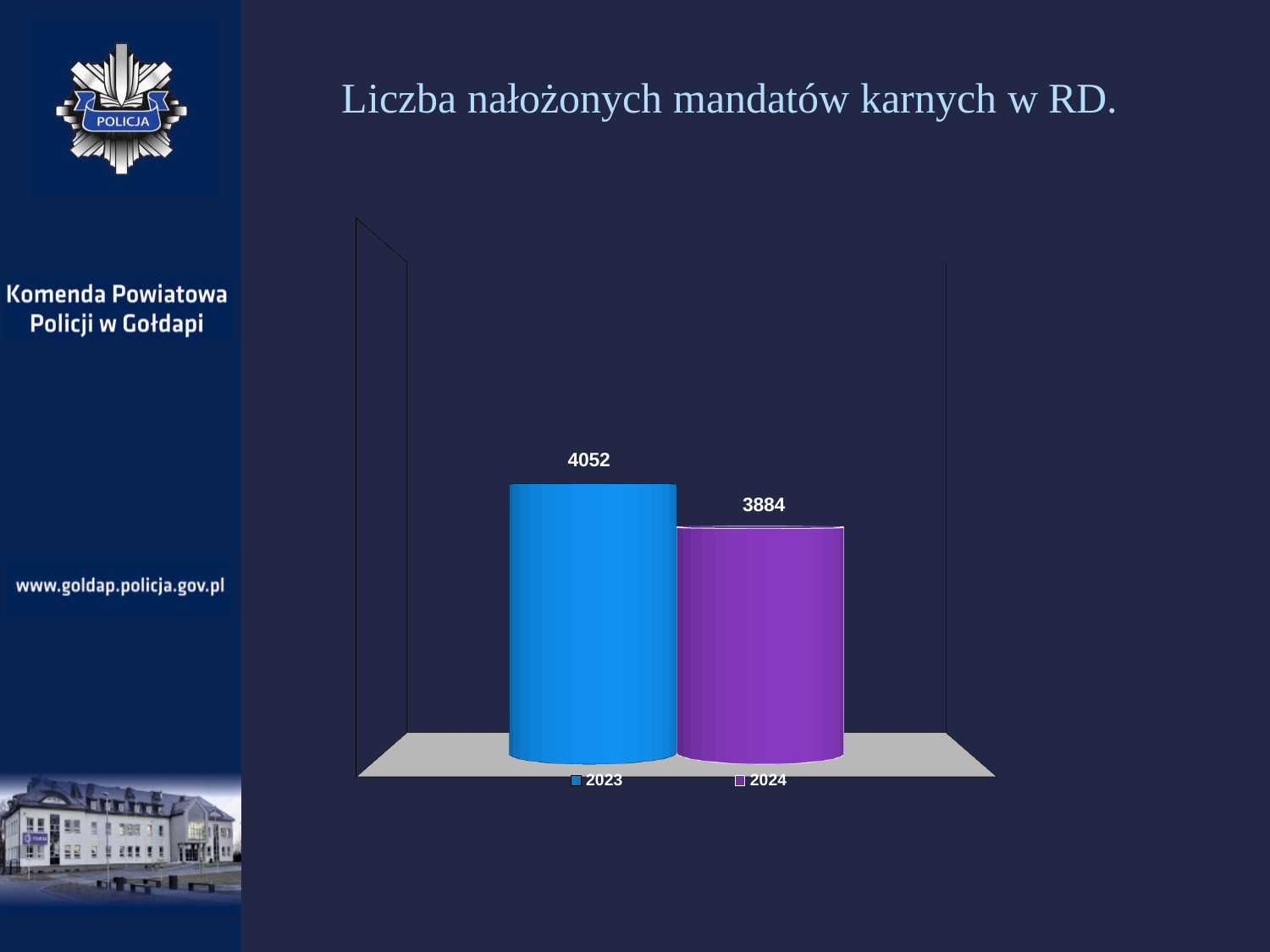
What is the difference between the values for 2023 and 2024? 168 What is the value for 2023? 4052 Which year has the higher value? 2023 Which year has the lower value? 2024 What is the value for 2024? 3884 How many series does the legend list? 2 What kind of chart is shown on the slide? bar chart Do the values rise or fall from 2023 to 2024? fall What is the title of the chart? Liczba nałożonych mandatów karnych w RD. Is the value for 2024 larger or smaller than the value for 2023? smaller What colour is the bar for 2024? purple How many bars are plotted on the chart? 2